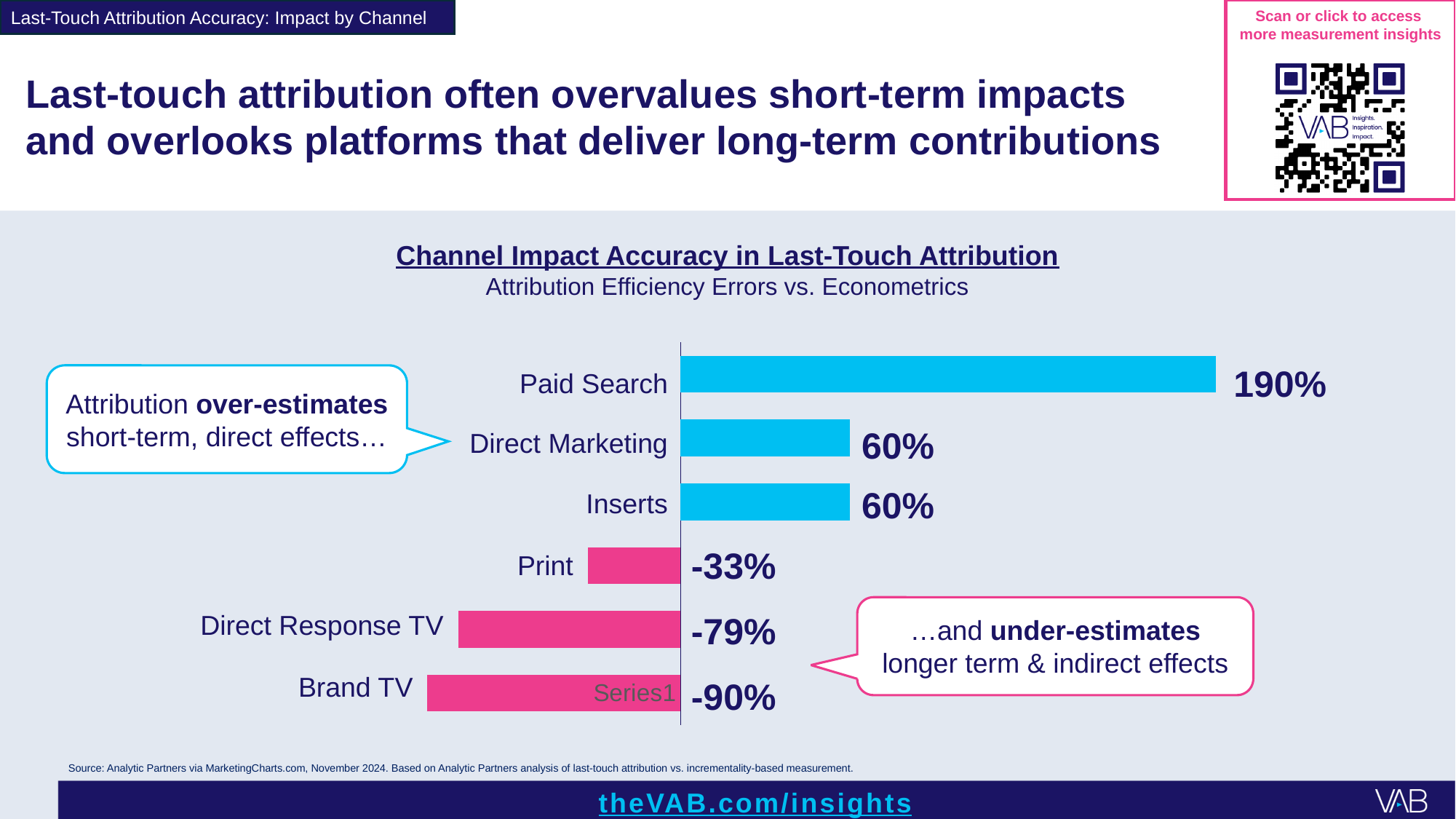
Which is larger, the value for Print or the value for Direct Response TV? Print What is the value for Direct Response TV? -79% How many channels are shown in the chart? 6 What kind of chart is shown on the slide? Bar chart Which channel has the highest value? Paid Search What is the difference between the values for Paid Search and Direct Marketing? 130% Which channel has the lowest value? Brand TV What is the title of the chart? Channel Impact Accuracy in Last-Touch Attribution What is the value for Brand TV? -90% What colour are the bars for channels with negative values? Pink What is the value for Print? -33% What is the value for Paid Search? 190%